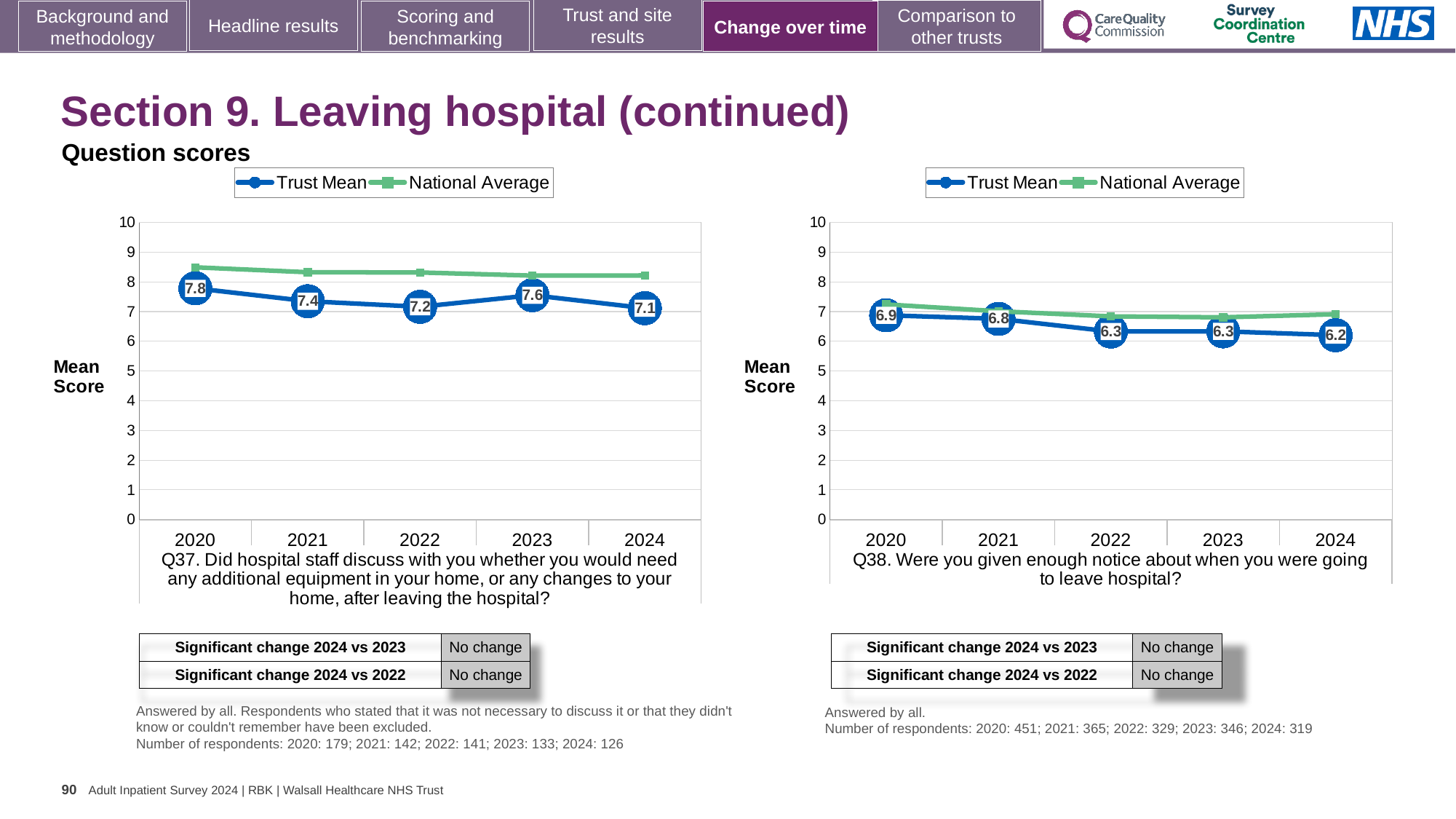
On the Q38 chart (right), what is the difference between the Trust Mean scores for 2021 and 2022? 0.5 On the Q37 chart (left), is the National Average for 2020 greater or less than 8? greater On the Q37 chart (left), which is larger: the Trust Mean for 2021 or the Trust Mean for 2023? 2023 On the Q37 chart (left), what is the difference between the Trust Mean scores for 2020 and 2024? 0.7 What kind of chart is the Q38 chart (right)? Line chart How many series does the legend of the Q37 chart (left) list? 2 On the Q38 chart (right), what is the Trust Mean score for 2024? 6.2 On the Q38 chart (right), which year has the highest Trust Mean score? 2020 On the Q37 chart (left), which year has the lowest Trust Mean score? 2024 On the Q38 chart (right), is the National Average for 2022 greater or less than 7? less On the Q37 chart (left), what is the Trust Mean score for 2020? 7.8 How many years are shown on the x axis of the Q38 chart (right)? 5